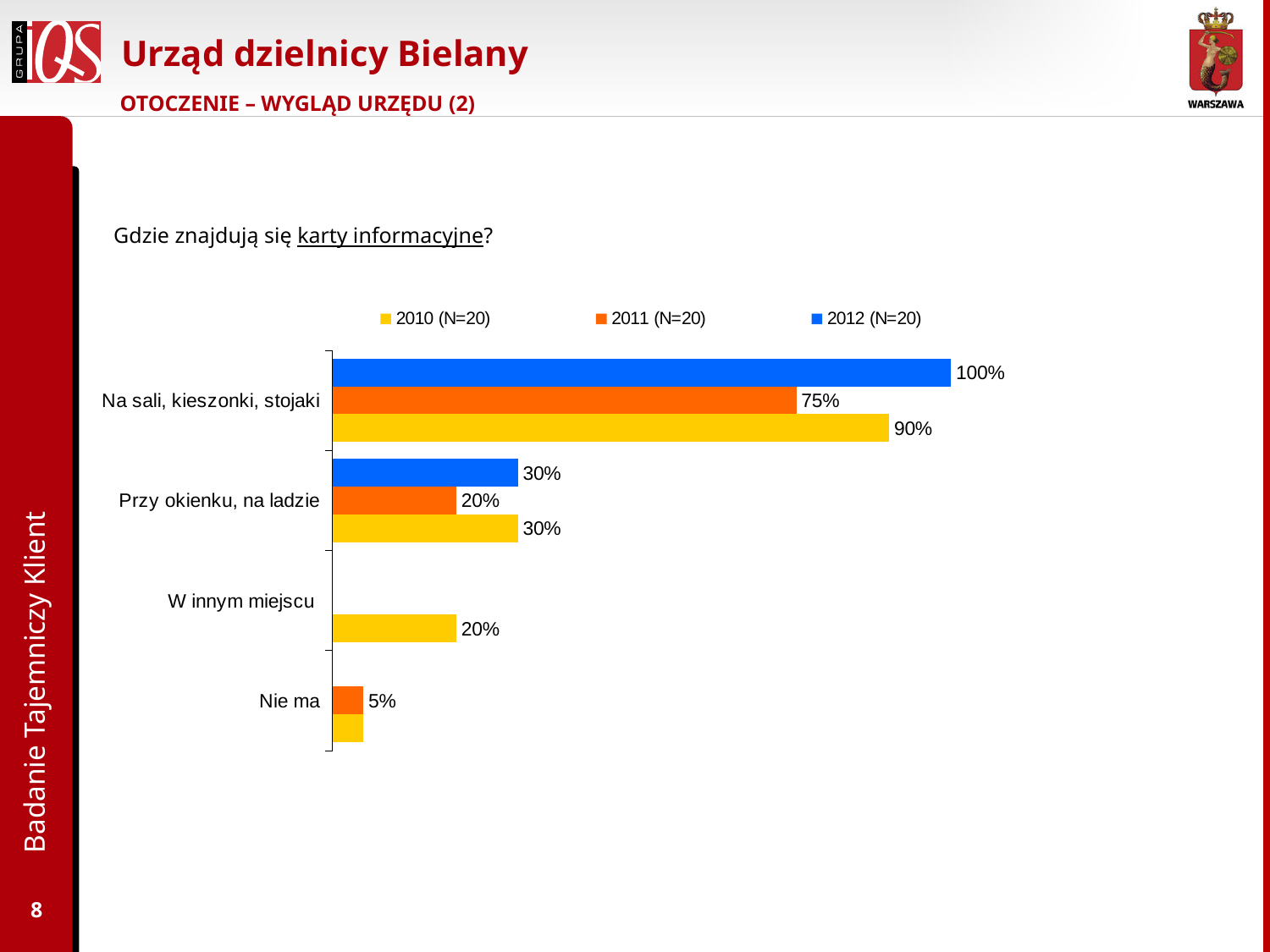
For "Przy okienku, na ladzie", which is larger: the 2012 value or the 2011 value? 2012 What is the difference between the 2012 and 2011 values for "Na sali, kieszonki, stojaki"? 25% What is the 2011 (N=20) value for "Nie ma"? 5% What is the 2011 (N=20) value for "Na sali, kieszonki, stojaki"? 75% Which category has the highest 2012 (N=20) value? Na sali, kieszonki, stojaki What is the 2010 (N=20) value for "W innym miejscu"? 20% Which colour represents the 2011 (N=20) series in the legend? orange How many categories are shown on the chart? 4 How many series does the legend list? 3 What is the 2010 (N=20) value for "Przy okienku, na ladzie"? 30% What is the 2012 (N=20) value for "Na sali, kieszonki, stojaki"? 100% What kind of chart is shown on the slide? bar chart